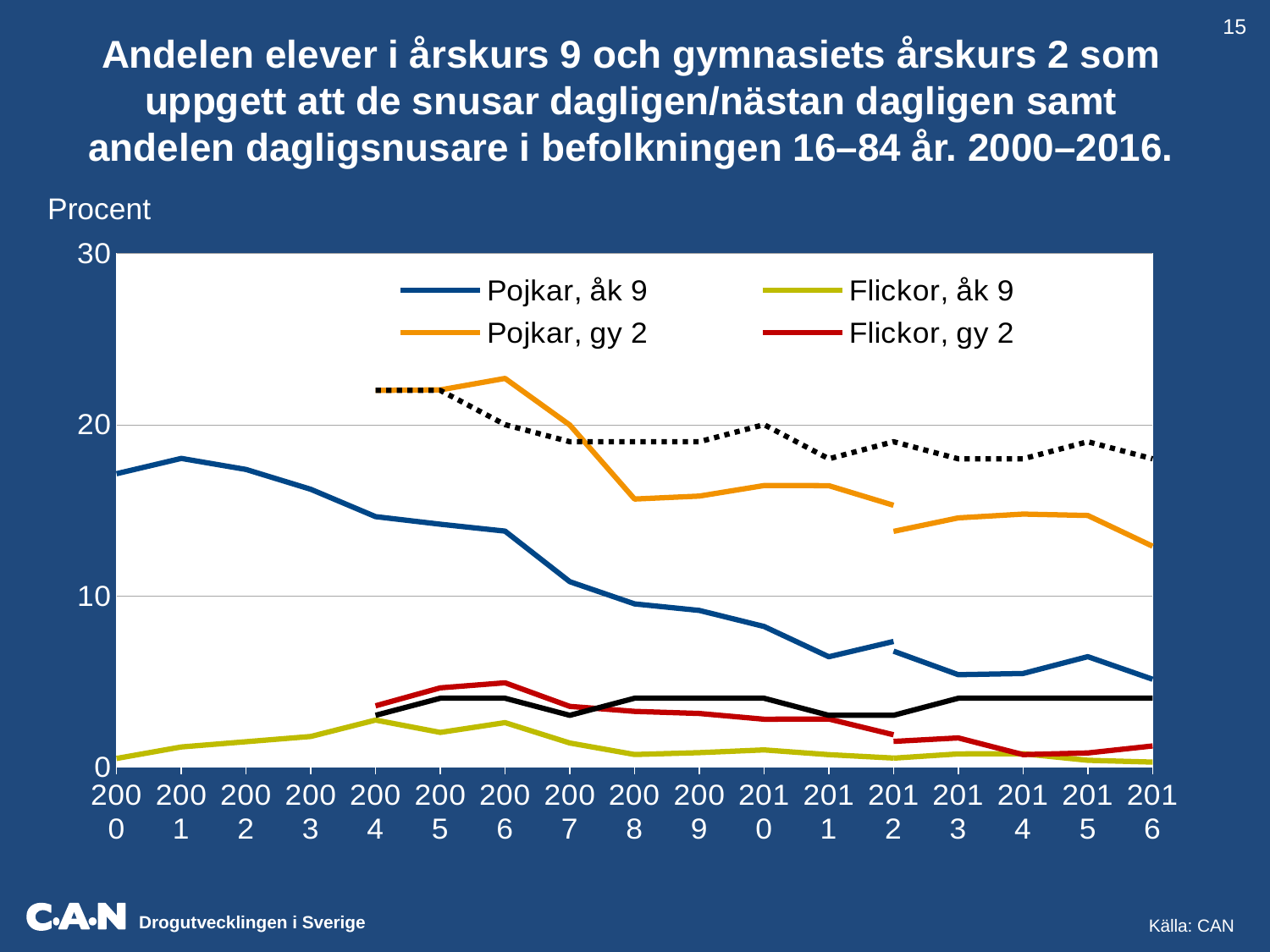
Which legend series has the highest value in 2016? Pojkar, gy 2 Does the Pojkar, åk 9 line rise or fall from 2000 to 2016? fall In 2010, which is higher: Pojkar, gy 2 or Pojkar, åk 9? Pojkar, gy 2 How many years are shown along the x axis? 17 What kind of chart is shown on the slide? line chart Is the value for Pojkar, gy 2 in 2006 greater or less than 20? greater Is the value for Pojkar, åk 9 in 2016 greater or less than 10? less Which legend series has the lowest value in 2016? Flickor, åk 9 Is the value for Pojkar, gy 2 in 2016 greater or less than 10? greater How many series does the legend list? 4 What unit label is shown above the y axis? Procent